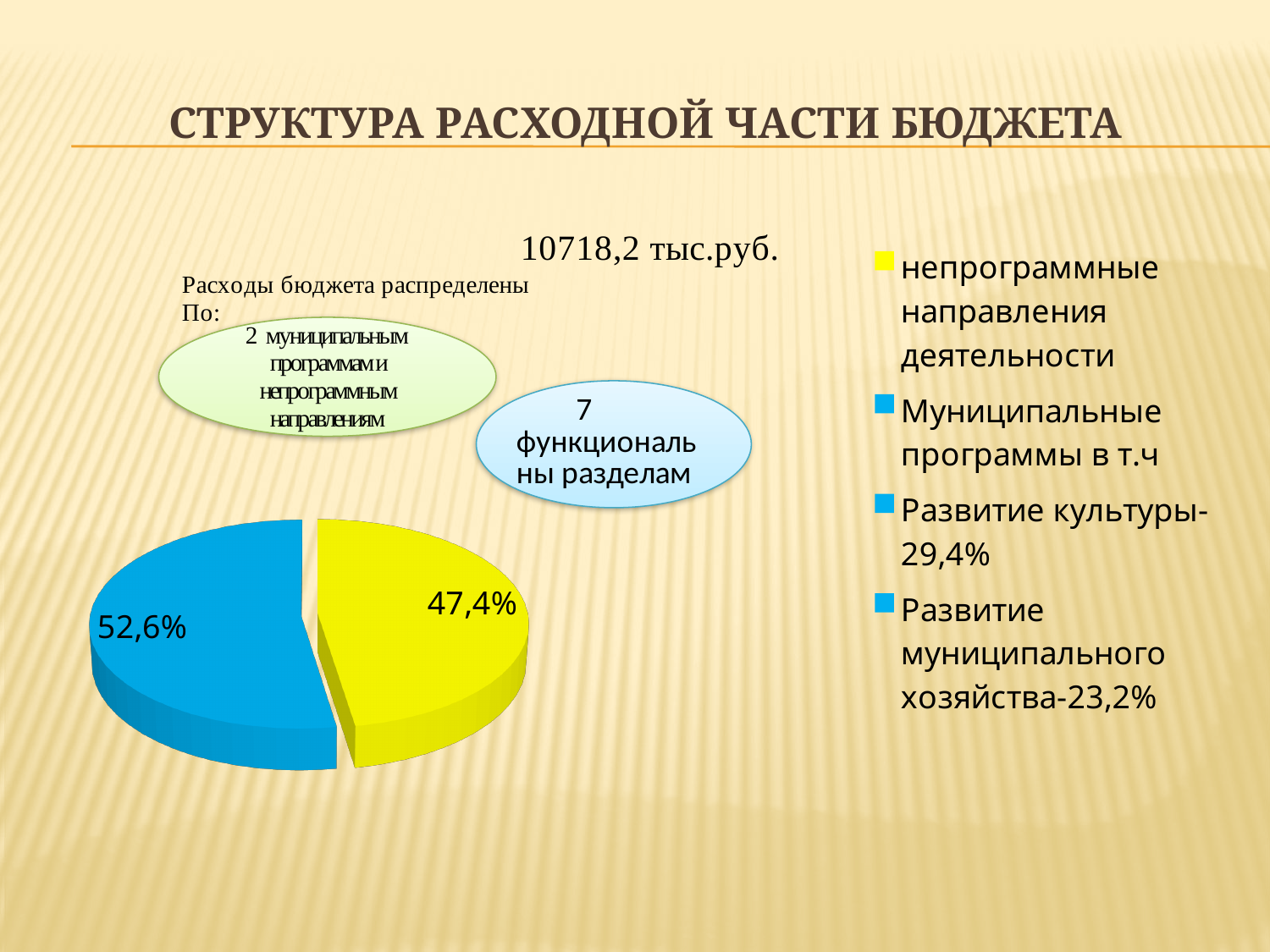
According to the legend, what share is given for Развитие культуры? 29,4% How many slices does the pie chart have? 2 According to the legend, what share is given for Развитие муниципального хозяйства? 23,2% Which category has the smallest share of the pie? непрограммные направления деятельности What is the difference in percentage points between the blue slice (52,6%) and the yellow slice (47,4%)? 5,2 What is the title of the slide containing the pie chart? СТРУКТУРА РАСХОДНОЙ ЧАСТИ БЮДЖЕТА How many entries does the legend list? 4 What kind of chart is shown on the slide? pie chart What share of the pie does the blue slice (Муниципальные программы) represent? 52,6% Which slice of the pie is larger, the yellow one or the blue one? the blue one (52,6%) Which category has the largest share of the pie? Муниципальные программы What share of the pie does the yellow slice (непрограммные направления деятельности) represent? 47,4%